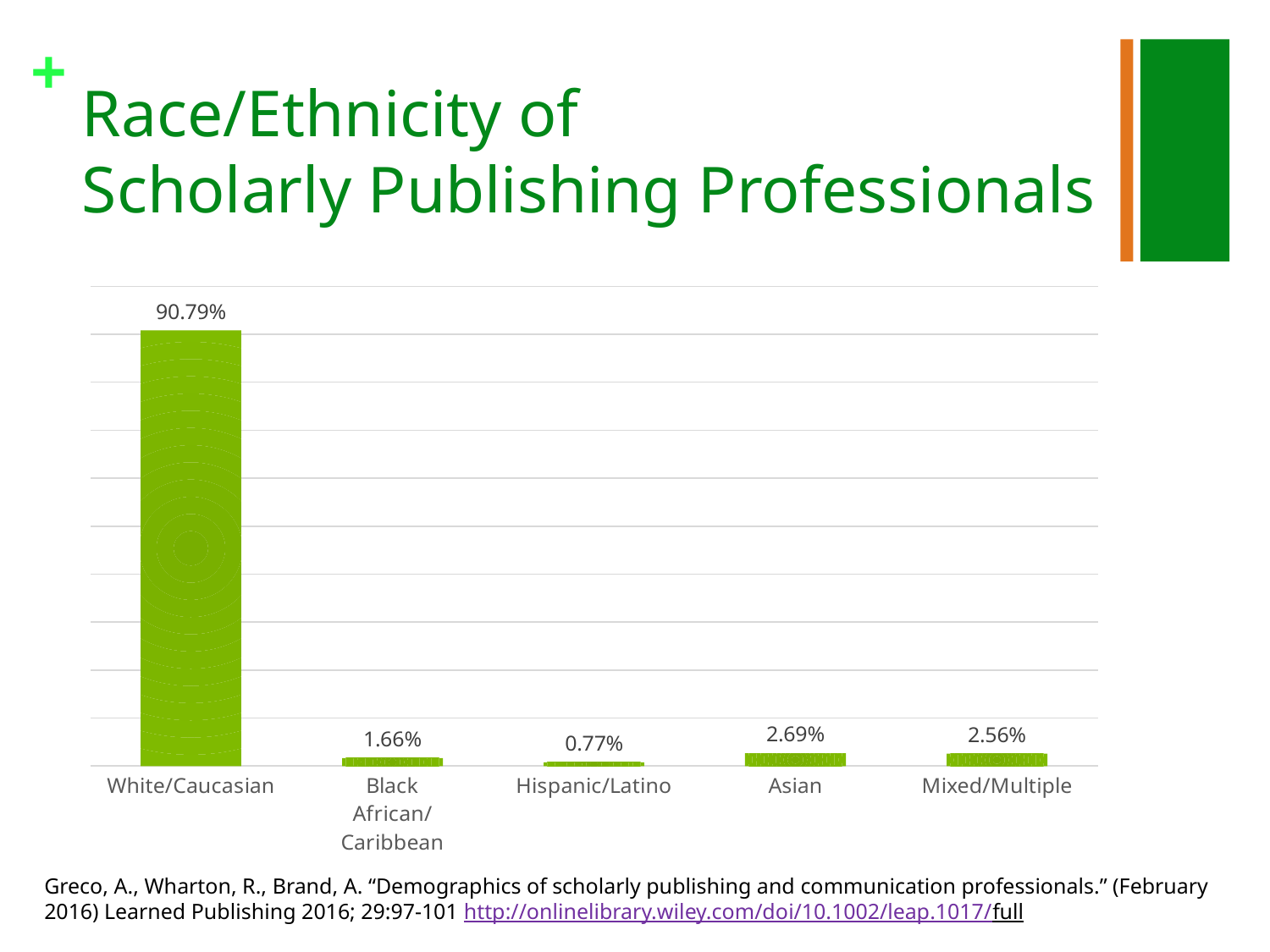
Which is larger, the value for Black African/Caribbean or the value for Mixed/Multiple? Mixed/Multiple What is the value for Black African/Caribbean? 1.66% What is the title of the slide? Race/Ethnicity of Scholarly Publishing Professionals What is the value for Hispanic/Latino? 0.77% What is the difference between the values for Asian and Hispanic/Latino? 1.92% What is the value for White/Caucasian? 90.79% Which category has the highest value? White/Caucasian Which category has the lowest value? Hispanic/Latino What is the value for Mixed/Multiple? 2.56% What is the value for Asian? 2.69% How many categories are shown in the chart? 5 What kind of chart is shown on the slide? Bar chart